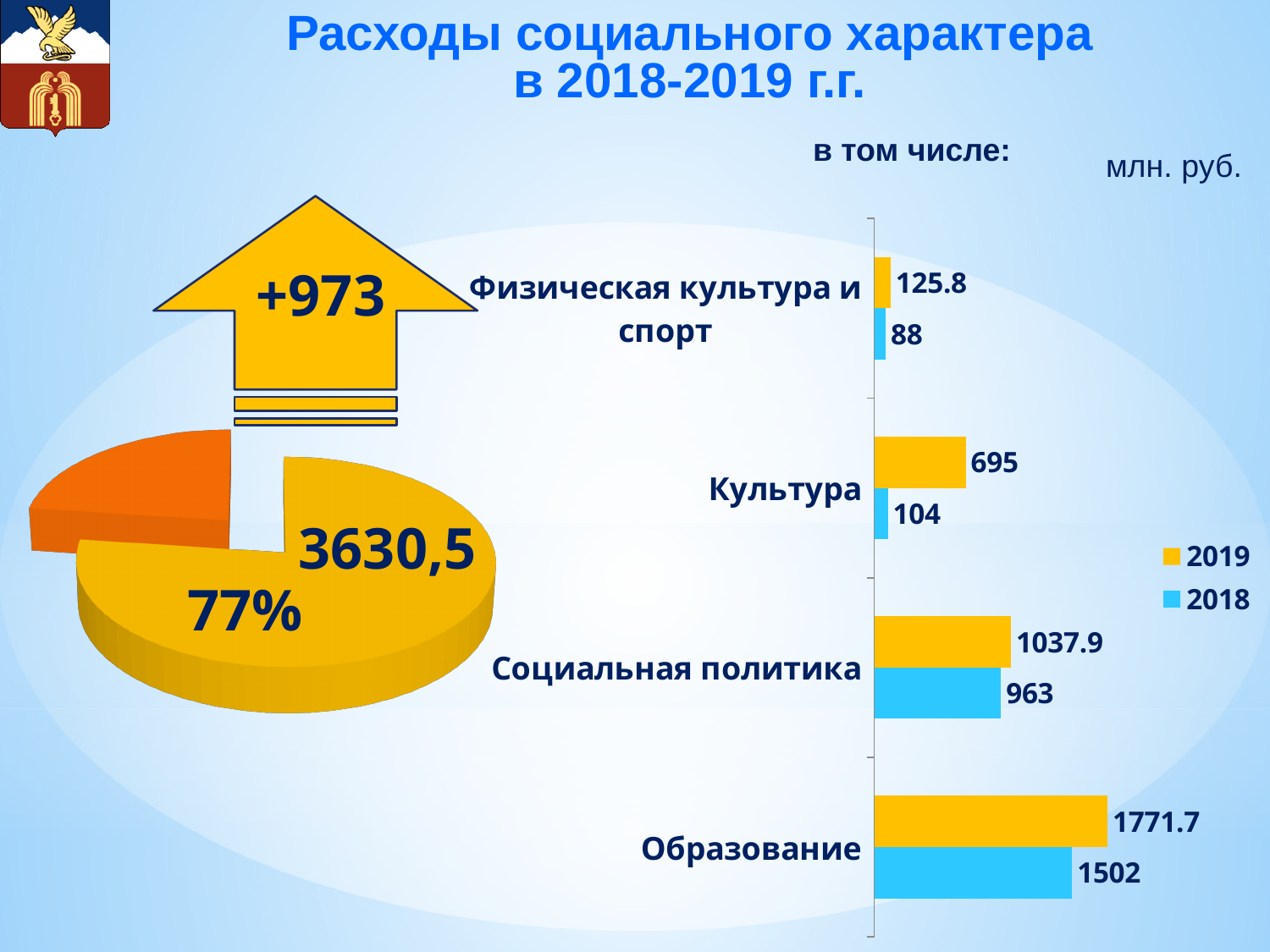
In the bar chart on the right, what is the difference between the 2019 and 2018 values for Образование? 269.7 In the bar chart on the right, which category has the highest 2019 value? Образование In the bar chart on the right, what is the 2018 value for Культура? 104 In the bar chart on the right, which is larger: the 2018 value for Социальная политика or the 2019 value for Культура? 2018 value for Социальная политика In the bar chart on the right, which category has the lowest 2018 value? Физическая культура и спорт In the pie chart on the left, what share is shown for the yellow slice labelled 3630,5? 77% In the bar chart on the right, what is the 2019 value for Образование? 1771.7 In the bar chart on the right, what is the difference between the 2019 and 2018 values for Культура? 591 In the bar chart on the right, what is the 2019 value for Социальная политика? 1037.9 In the bar chart on the right, what is the 2018 value for Физическая культура и спорт? 88 How many series does the legend of the bar chart on the right list? 2 How many categories does the bar chart on the right show? 4